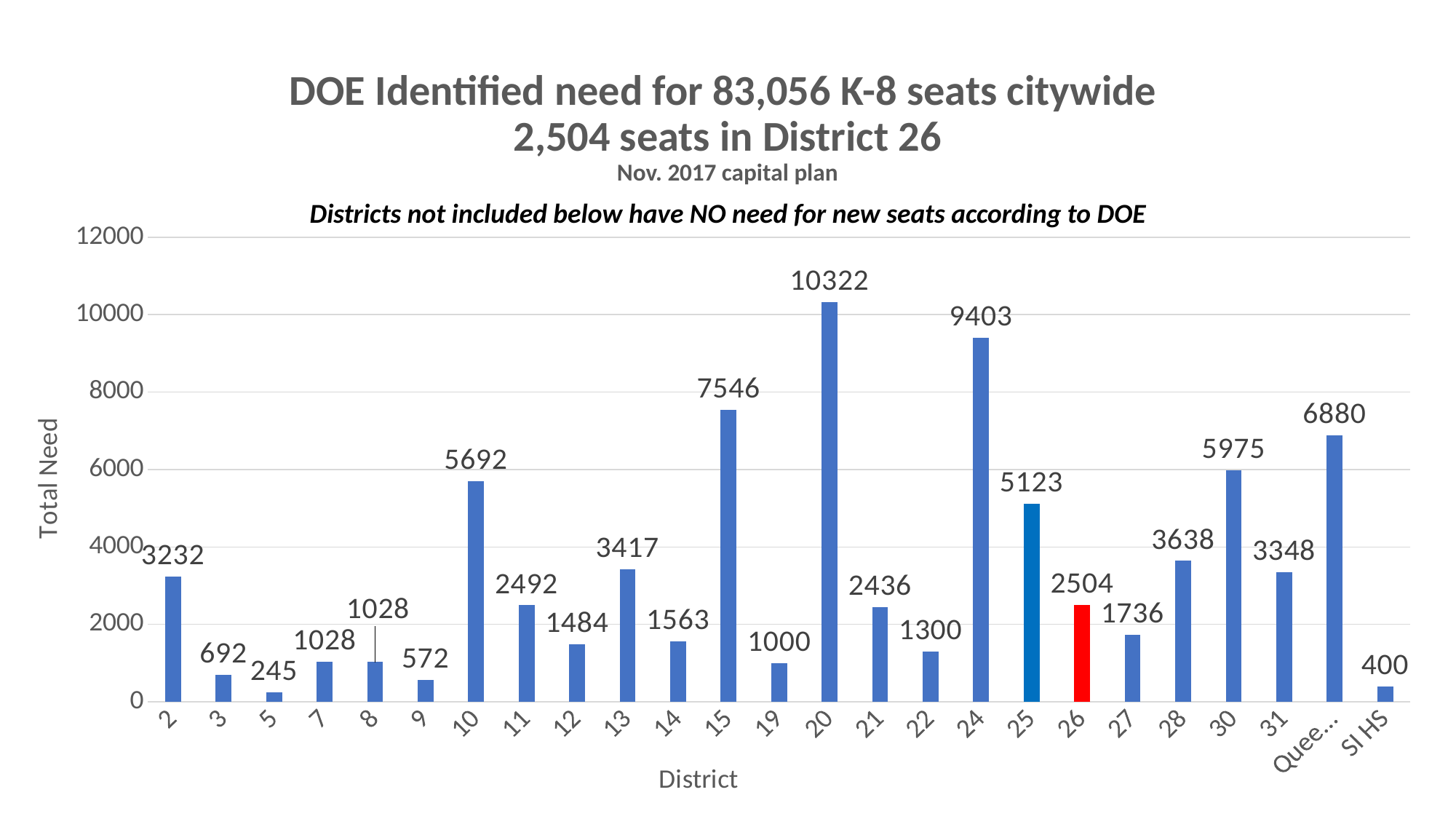
What is the difference in total need between District 20 and District 24? 919 What kind of chart is shown on the slide? bar chart What is the total need for SI HS? 400 Which has a larger total need, District 10 or District 25? District 10 Which district has the lowest total need? 5 How many districts are shown on the x axis? 25 What is the total need for District 15? 7546 Which district's bar is coloured red? 26 What is the difference in total need between District 30 and District 26? 3471 What is the total need for District 26? 2504 Which district has the highest total need? 20 Is the value for District 28 greater or less than 4000? less